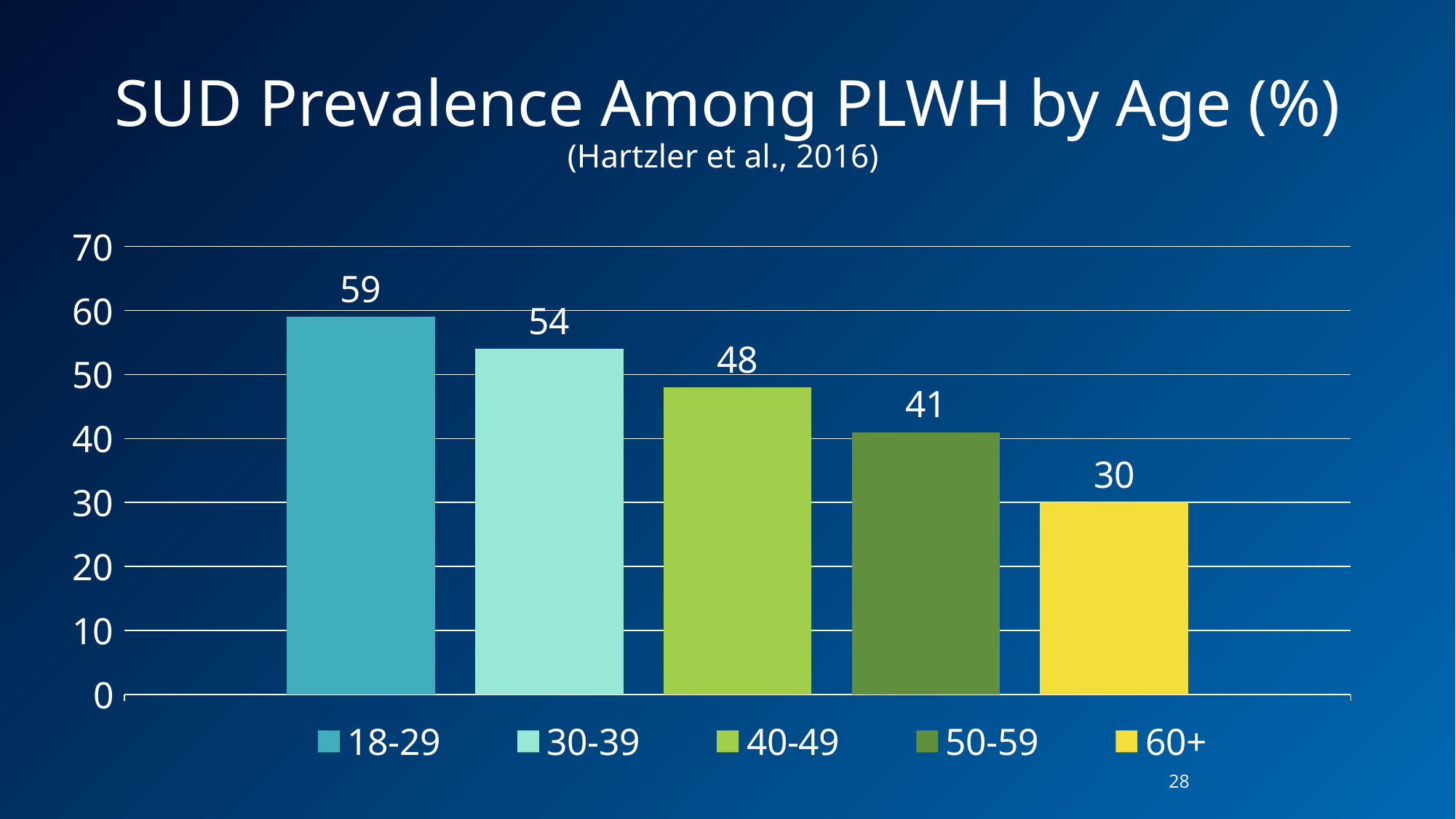
How many age groups are shown in the chart? 5 Do the values rise or fall as age group increases from left to right? fall Which is larger, the value for 40-49 or the value for 50-59? 40-49 What is the title of the chart? SUD Prevalence Among PLWH by Age (%) What is the SUD prevalence value for the 40-49 age group? 48 What kind of chart is shown on the slide? bar chart What is the SUD prevalence value for the 60+ age group? 30 Which age group has the highest SUD prevalence? 18-29 Is the value for the 30-39 age group greater or less than 50? greater Which age group has the lowest SUD prevalence? 60+ What is the difference between the values for the 30-39 and 50-59 age groups? 13 What is the SUD prevalence value for the 18-29 age group? 59